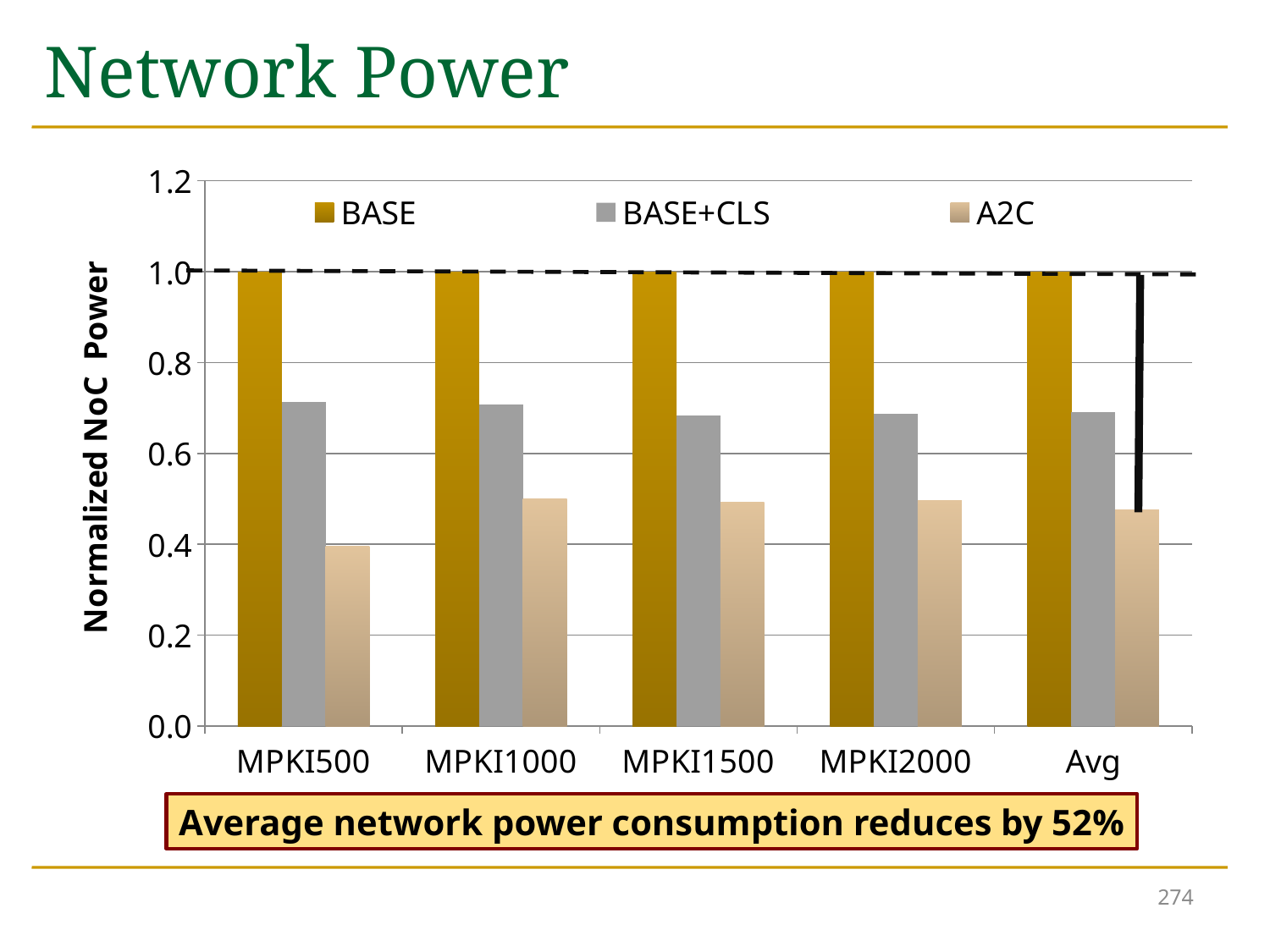
How many series does the legend list? 3 Is the value for BASE+CLS at MPKI2000 greater or less than 0.8? less Is the value for A2C at Avg greater or less than 0.6? less How many categories are shown on the x axis? 5 At MPKI1500, which is larger: BASE+CLS or A2C? BASE+CLS Which category has the lowest A2C value? MPKI500 What kind of chart is shown on the slide? bar chart Is the value for A2C at MPKI500 greater or less than 0.6? less What is the normalized NoC power for BASE at MPKI1000? 1.0 What is the label of the y axis? Normalized NoC Power What is the normalized NoC power for BASE at Avg? 1.0